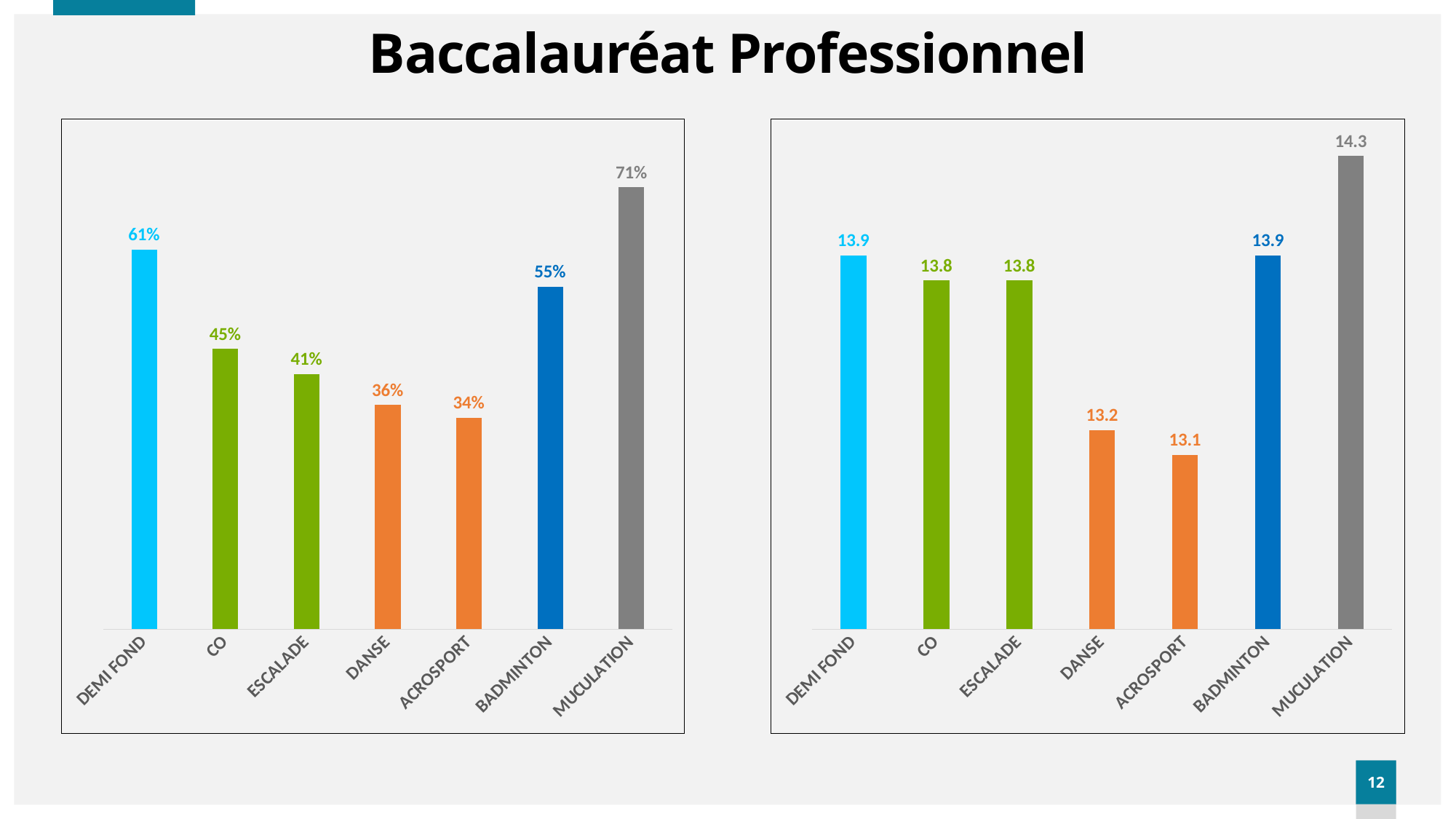
In the right chart, what is the value for ESCALADE? 13.8 In the left chart, which category has the lowest value? ACROSPORT In the left chart, what is the value for MUCULATION? 71% In the left chart, what is the difference between the values for DEMI FOND and BADMINTON? 6% In the right chart, what is the difference between the values for MUCULATION and ACROSPORT? 1.2 How many categories are shown in the right chart? 7 In the right chart, which category has the highest value? MUCULATION In the right chart, what is the value for DANSE? 13.2 In the left chart, which category has the highest value? MUCULATION In the left chart, what is the value for ACROSPORT? 34% In the left chart, which is larger, the value for CO or the value for DANSE? CO In the right chart, which category has the lowest value? ACROSPORT